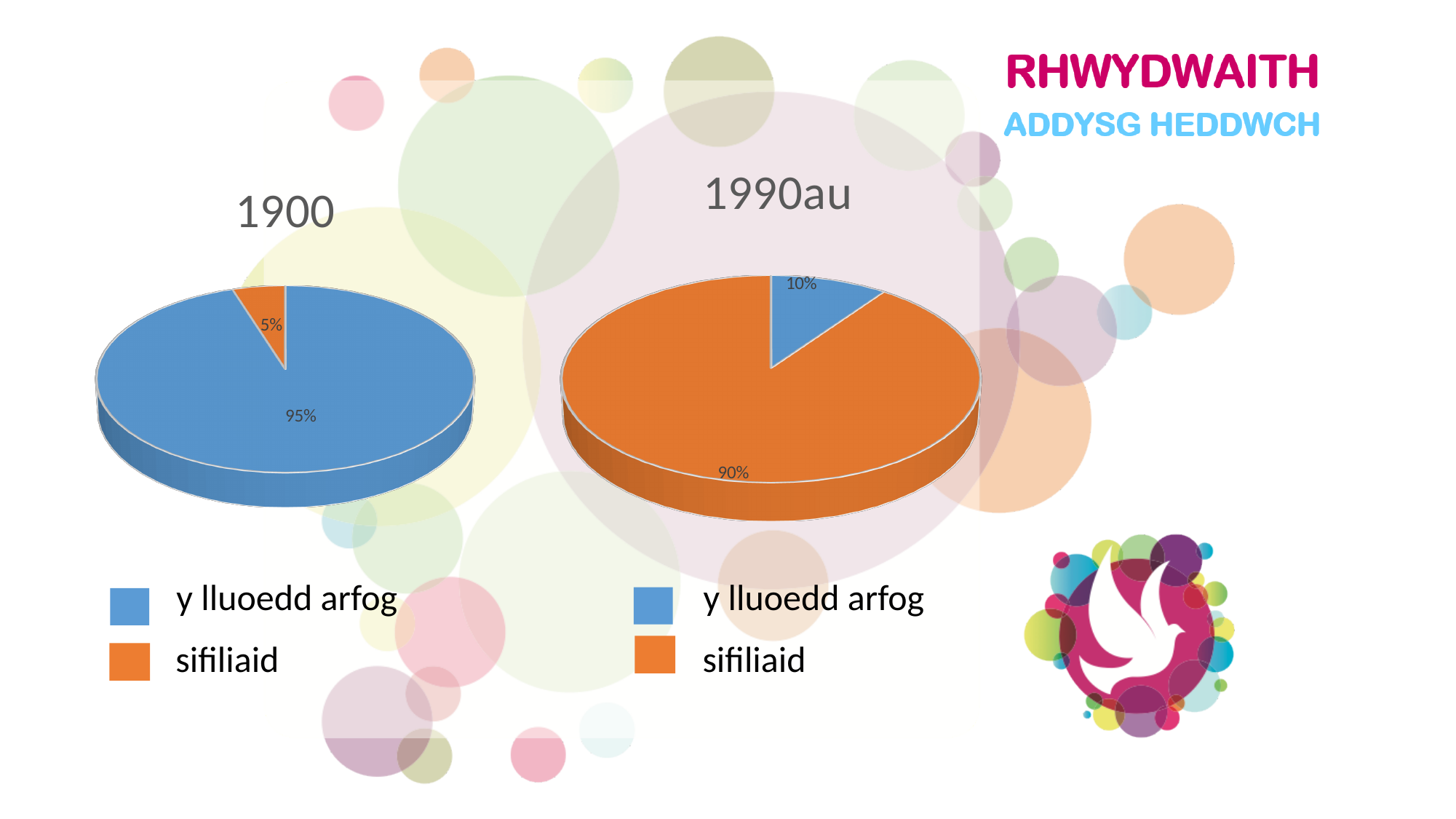
In the 1990au chart, what colour is the sifiliaid slice? orange In the 1990au chart, what share is shown for y lluoedd arfog? 10% What type of chart is the 1900 chart? pie chart Which is larger: the sifiliaid share in the 1900 chart or the sifiliaid share in the 1990au chart? the 1990au chart How many entries does the legend under the 1900 chart list? 2 In the 1990au chart, what share is shown for sifiliaid? 90% In the 1990au chart, what is the difference between the sifiliaid share and the y lluoedd arfog share? 80% In the 1900 chart, which category has the largest slice? y lluoedd arfog How many slices does the 1990au chart have? 2 In the 1900 chart, what share is shown for y lluoedd arfog? 95% In the 1990au chart, which category has the smallest slice? y lluoedd arfog In the 1900 chart, what share is shown for sifiliaid? 5%